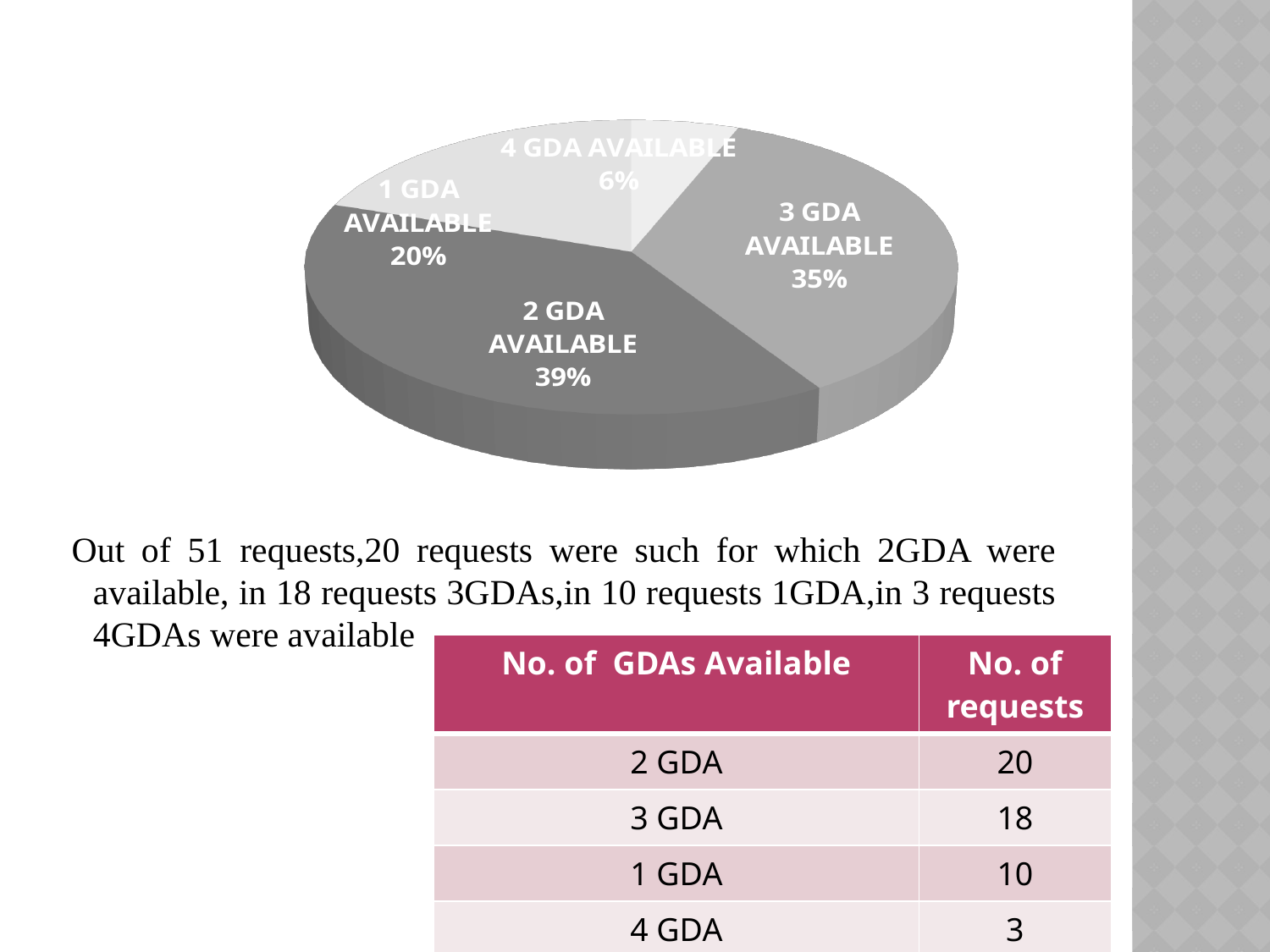
What share of the pie does the 3 GDA AVAILABLE slice represent? 35% Which slice of the pie chart is the smallest? 4 GDA AVAILABLE What percentage is shown for the 3 GDA AVAILABLE slice? 35% What percentage is shown for the 2 GDA AVAILABLE slice? 39% How many slices does the pie chart have? 4 What is the difference in percentage points between the 2 GDA AVAILABLE and 3 GDA AVAILABLE slices? 4 Which slice of the pie chart is the largest? 2 GDA AVAILABLE What kind of chart is shown on the slide? pie chart What percentage is shown for the 4 GDA AVAILABLE slice? 6% What percentage is shown for the 1 GDA AVAILABLE slice? 20% What is the difference in percentage points between the 1 GDA AVAILABLE and 4 GDA AVAILABLE slices? 14 Which is larger, the 1 GDA AVAILABLE slice or the 4 GDA AVAILABLE slice? 1 GDA AVAILABLE